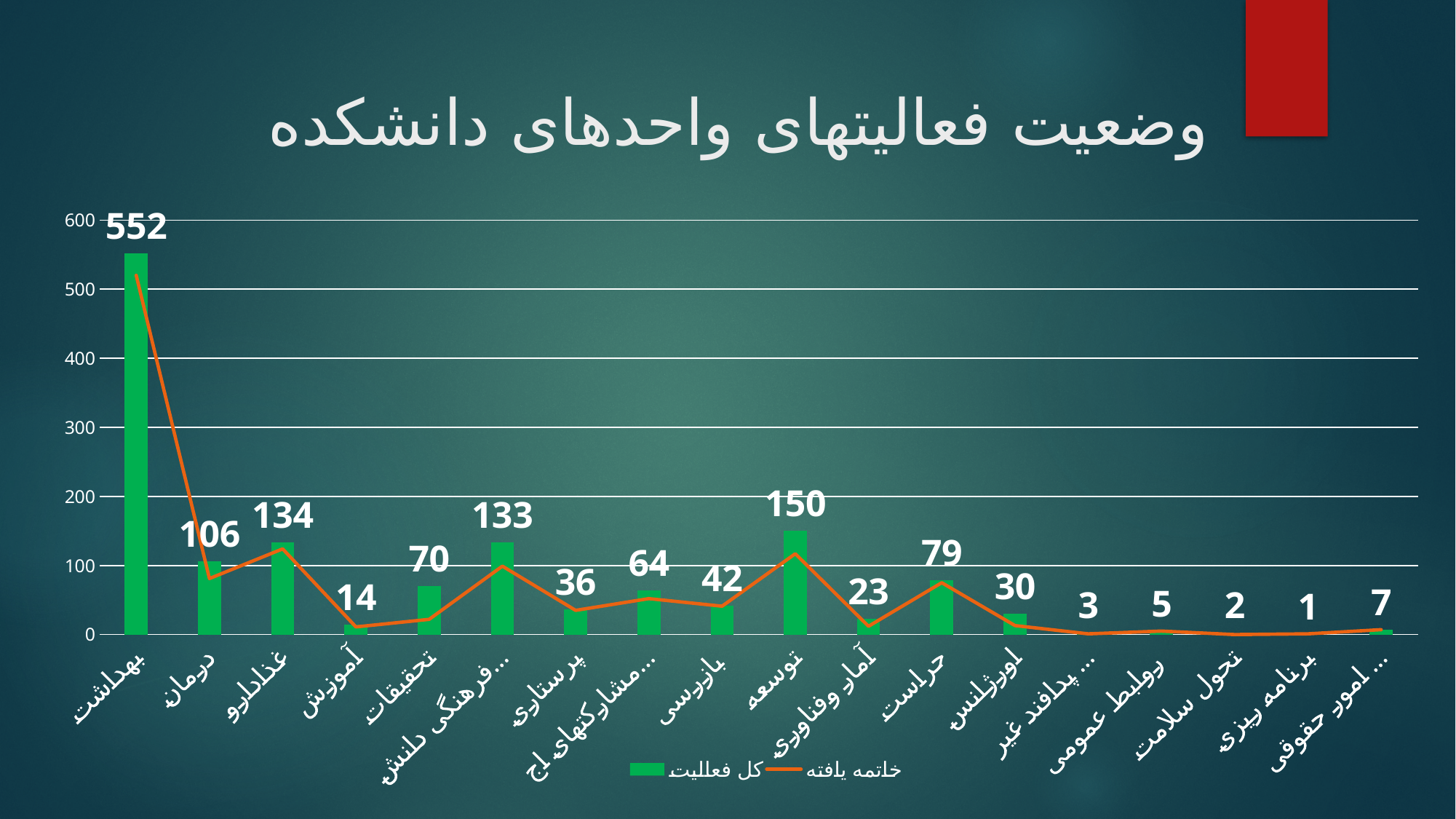
What is the value of the کل فعالیت bar for بهداشت? 552 How many series does the legend list? 2 Which category has the highest کل فعالیت value? بهداشت What kind of chart is shown on the slide? Bar chart with a line series What is the value of the کل فعالیت bar for حراست? 79 Is the خاتمه یافته line value for بهداشت greater or less than 400? greater What is the value of the کل فعالیت bar for توسعه? 150 Is the خاتمه یافته line value for درمان greater or less than 100? less Which category has the lowest کل فعالیت value? برنامه ریزی What is the difference between the کل فعالیت values for غذا و دارو and درمان? 28 How many categories are shown on the x axis? 18 Which has a larger کل فعالیت value, توسعه or فرهنگی دانش...? توسعه